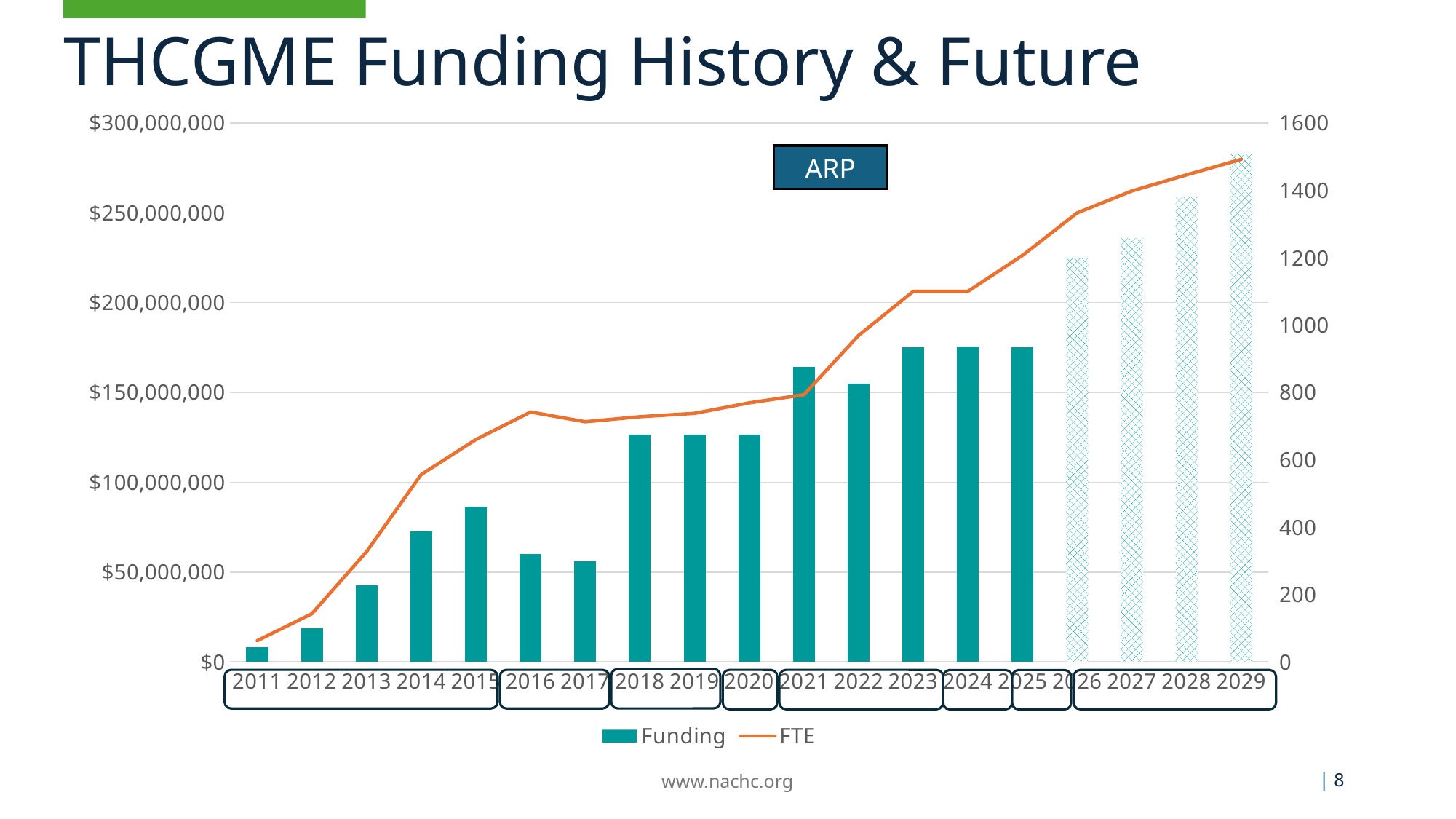
How many series does the legend list? 2 How many years are shown along the x axis? 19 Is the Funding value for 2011 greater or less than $50,000,000? less Does the FTE line generally rise or fall from 2011 to 2029? Rise What are the two series named in the legend? Funding and FTE Which year has the highest Funding bar? 2029 What type of chart is shown on the slide? A combined bar and line chart Is the Funding value for 2029 greater or less than $250,000,000? greater Which year has the larger Funding bar, 2021 or 2022? 2021 Is the FTE value for 2029 greater or less than 1400? greater Which year has the lowest Funding bar? 2011